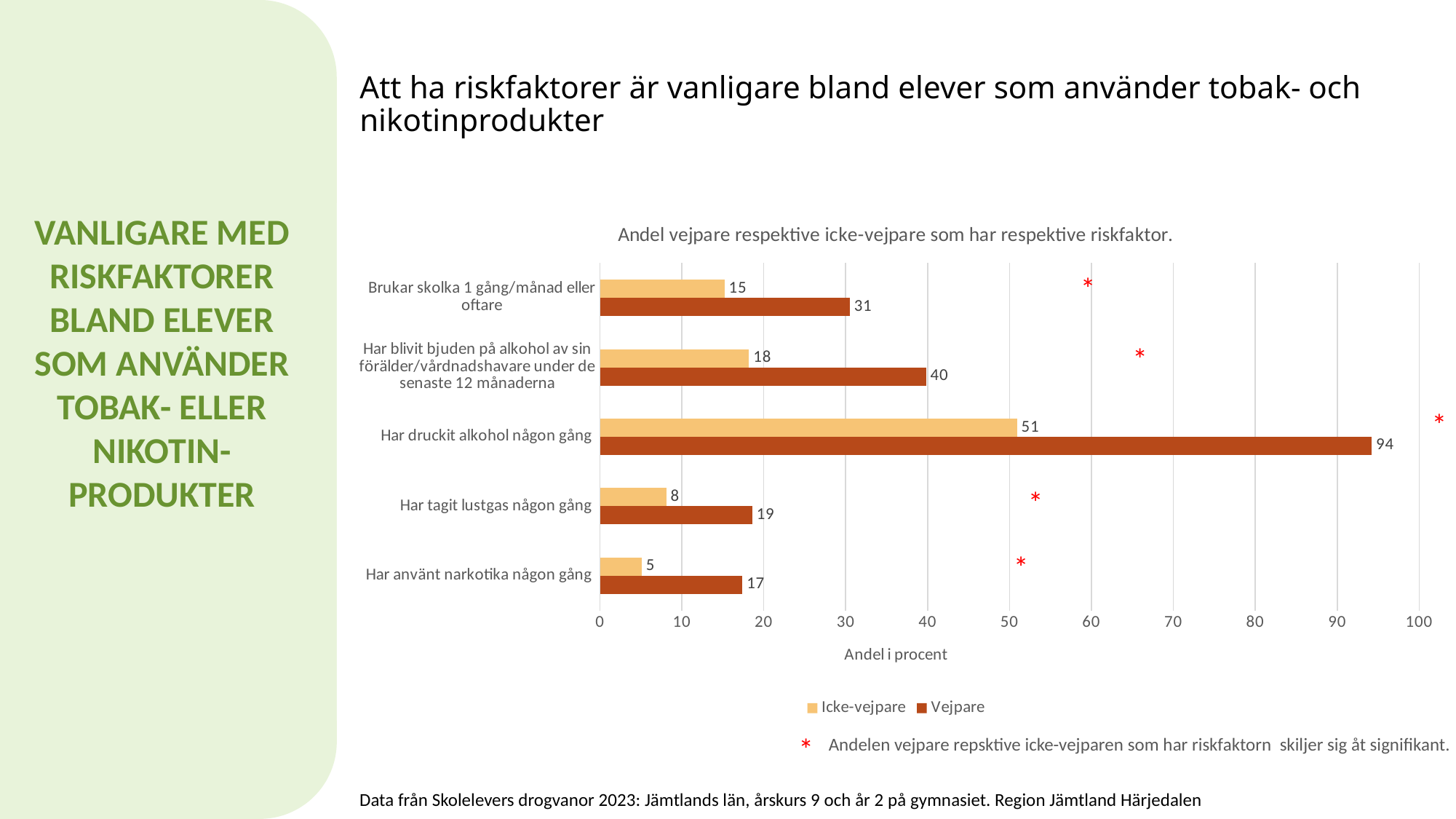
What is the value for Vejpare in the category 'Har druckit alkohol någon gång'? 94 What is the value for Icke-vejpare in the category 'Brukar skolka 1 gång/månad eller oftare'? 15 How many series does the legend list? 2 Which category has the lowest value for Vejpare? Har använt narkotika någon gång How many categories are shown on the chart? 5 What kind of chart is shown on the slide? Bar chart Which is larger: the Vejpare value for 'Har använt narkotika någon gång' or the Icke-vejpare value for 'Har blivit bjuden på alkohol av sin förälder/vårdnadshavare under de senaste 12 månaderna'? Icke-vejpare value for 'Har blivit bjuden på alkohol...' (18) What is the value for Vejpare in the category 'Har tagit lustgas någon gång'? 19 What is the title of the chart? Andel vejpare respektive icke-vejpare som har respektive riskfaktor. What is the label of the horizontal axis? Andel i procent What is the difference between the Vejpare and Icke-vejpare values for 'Har blivit bjuden på alkohol av sin förälder/vårdnadshavare under de senaste 12 månaderna'? 22 Which category has the highest value for Icke-vejpare? Har druckit alkohol någon gång